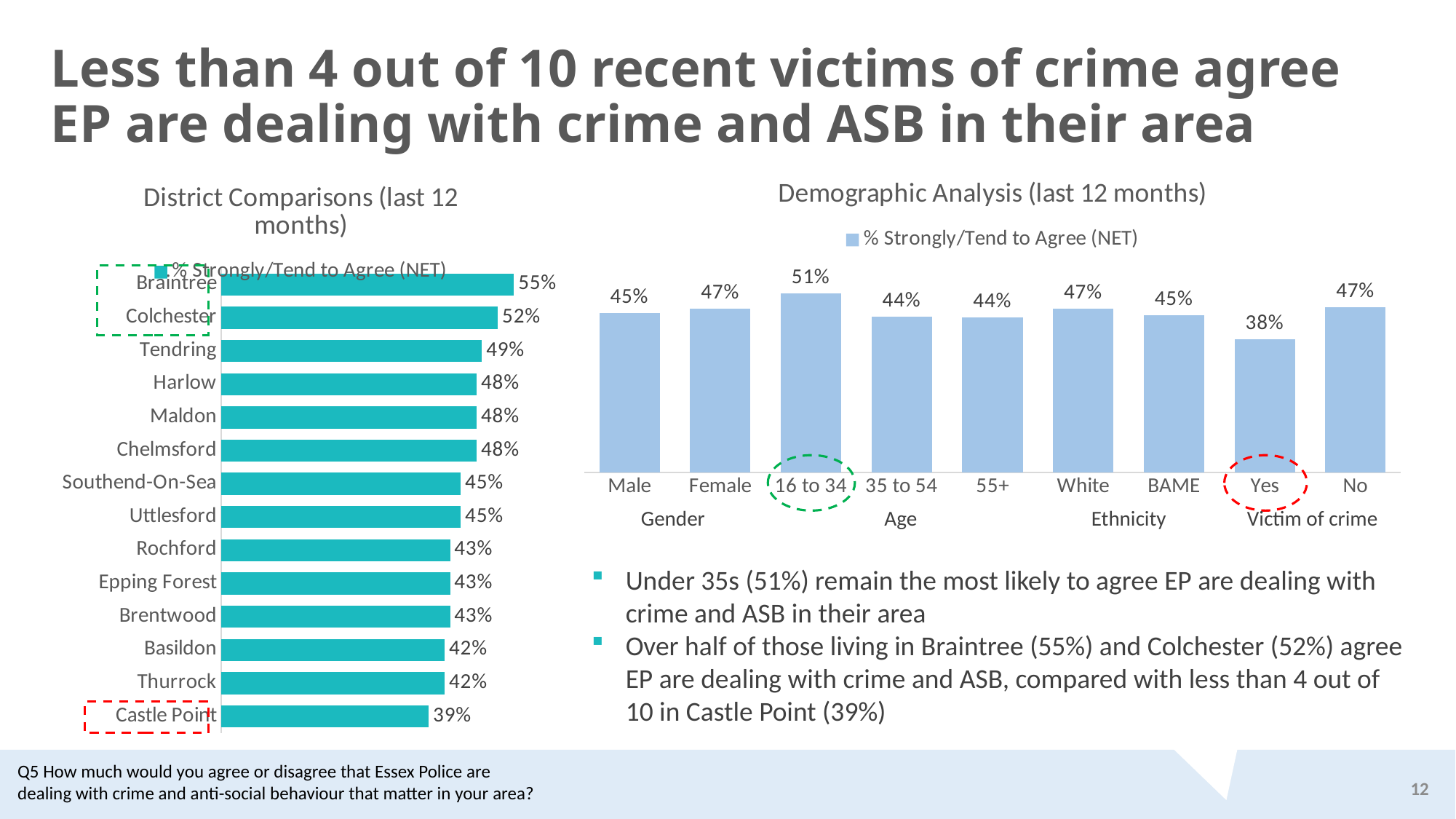
In the District Comparisons chart, what is the value for Tendring? 49% What type of chart is the Demographic Analysis chart? Bar chart In the Demographic Analysis chart, what is the value for 16 to 34? 51% In the District Comparisons chart, how many districts are shown? 14 In the Demographic Analysis chart, which category has the lowest value? Yes (Victim of crime) In the District Comparisons chart, which district has the lowest value? Castle Point In the Demographic Analysis chart, how many bars are plotted? 9 In the Demographic Analysis chart, what is the difference between No and Yes under Victim of crime? 9 percentage points In the District Comparisons chart, what is the difference between Braintree and Castle Point? 16 percentage points In the District Comparisons chart, which district has the highest value? Braintree In the Demographic Analysis chart, which is larger, Male or Female? Female In the District Comparisons chart, what is the value for Southend-On-Sea? 45%